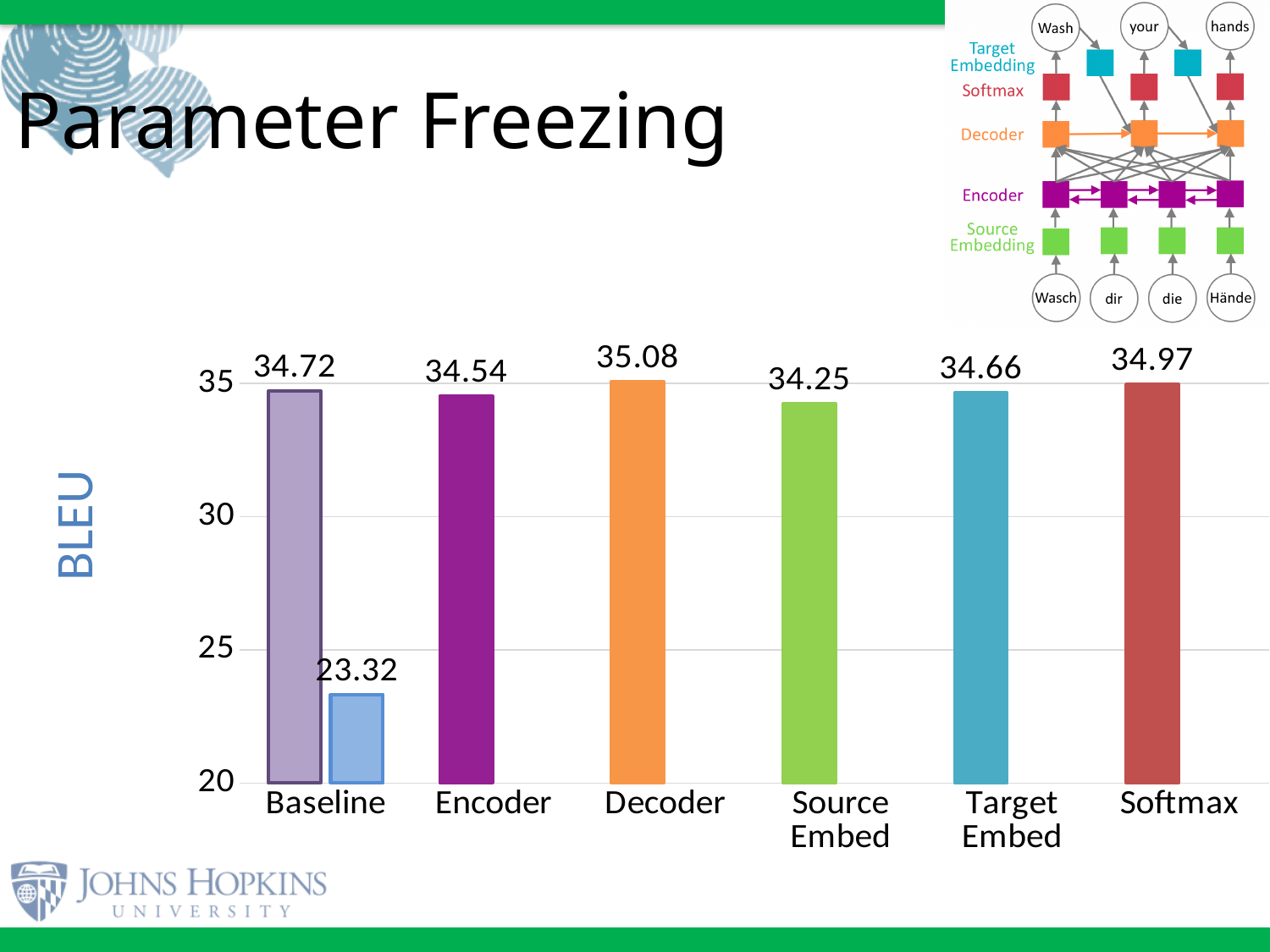
What is the BLEU value for Source Embed? 34.25 What kind of chart is shown on the slide? bar chart Is the value of the light blue Baseline bar greater or less than 25? less What is the difference between the Decoder value and the Source Embed value? 0.83 Which category has the highest BLEU value? Decoder How many categories are labelled on the x axis? 6 What is the BLEU value for Softmax? 34.97 What is the difference between the two Baseline bars (34.72 and 23.32)? 11.40 Among the single-bar categories (Encoder, Decoder, Source Embed, Target Embed, Softmax), which has the lowest BLEU value? Source Embed What is the BLEU value for Decoder? 35.08 Which is larger, the value for Encoder or the value for Target Embed? Target Embed What is the value of the smaller, light blue bar in the Baseline category? 23.32